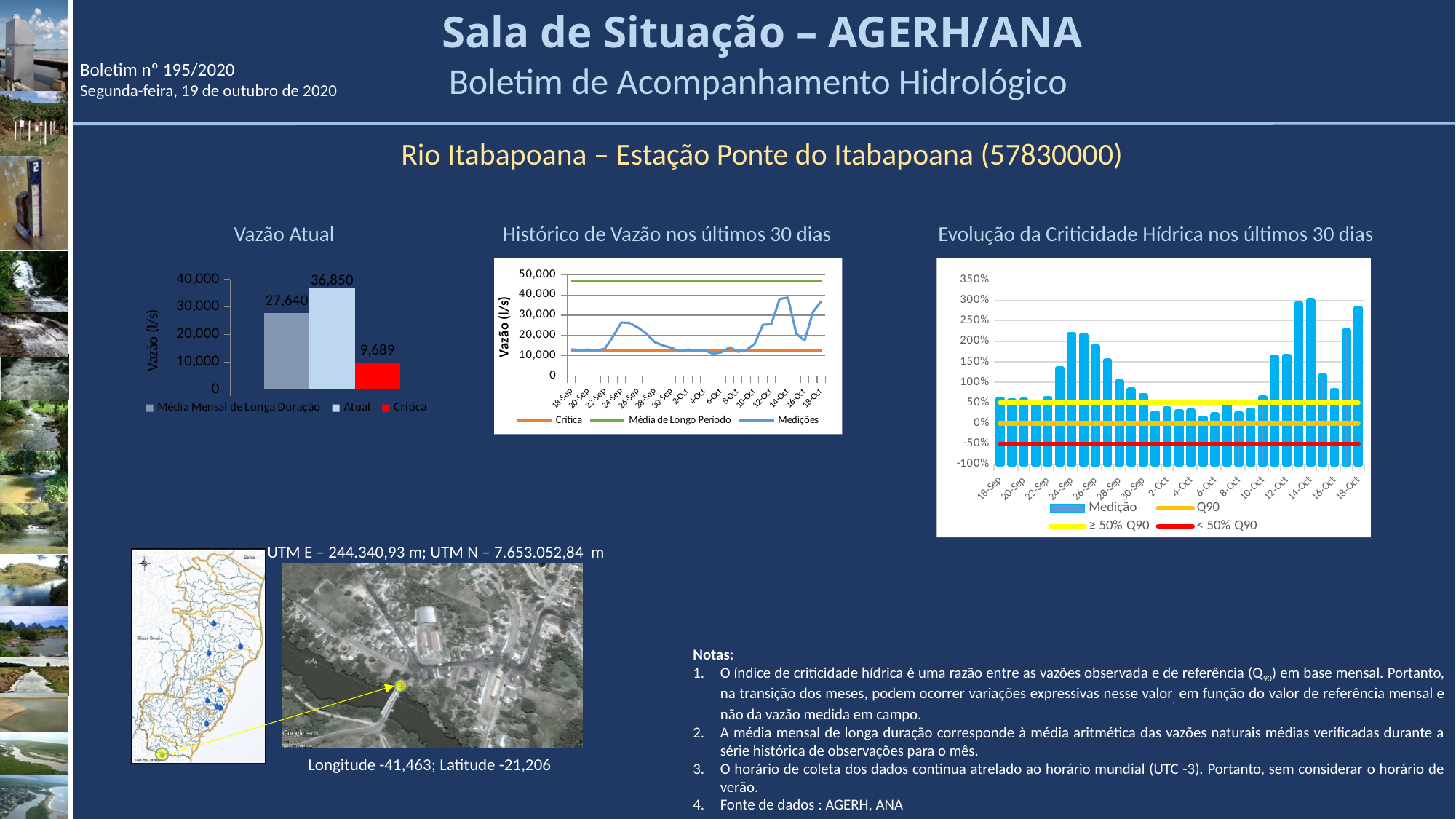
What kind of chart is 'Histórico de Vazão nos últimos 30 dias'? Line chart In the 'Vazão Atual' chart, which series has the lowest value? Crítica In the 'Vazão Atual' chart, which is larger: Média Mensal de Longa Duração or Crítica? Média Mensal de Longa Duração In the 'Vazão Atual' chart, what is the value for Crítica? 9,689 In the 'Histórico de Vazão nos últimos 30 dias' chart, how many series does the legend list? 3 In the 'Vazão Atual' chart, which series has the highest value? Atual In the 'Vazão Atual' chart, how many series does the legend list? 3 In the 'Vazão Atual' chart, what is the value for Média Mensal de Longa Duração? 27,640 In the 'Vazão Atual' chart, what is the value for Atual? 36,850 In the 'Histórico de Vazão nos últimos 30 dias' chart, is the Média de Longo Período line greater or less than 40,000? greater In the 'Vazão Atual' chart, what is the difference between the Atual value and the Média Mensal de Longa Duração value? 9,210 In the 'Evolução da Criticidade Hídrica nos últimos 30 dias' chart, is the Medição value for 14-Oct greater or less than 250%? greater